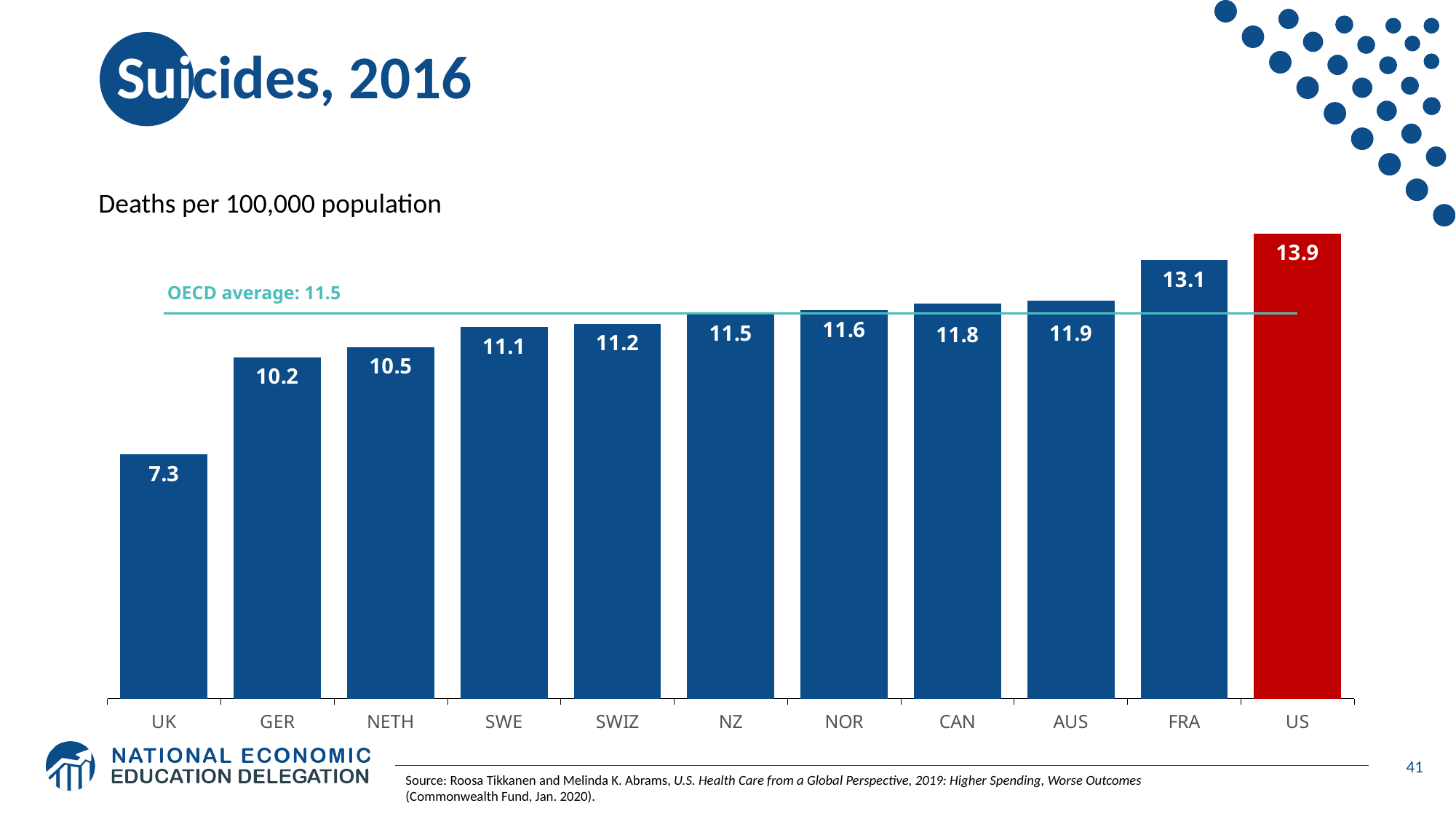
Which country has the lowest suicide rate on the chart? UK What is the difference between the FRA value and the GER value? 2.9 Which country has the highest suicide rate on the chart? US What kind of chart is shown on the slide? Bar chart What OECD average is marked by the horizontal line on the chart? 11.5 What is the value shown for FRA? 13.1 What is the difference between the US value and the UK value? 6.6 How many countries are shown on the chart? 11 Which has a higher value, CAN or NETH? CAN Do the values rise or fall moving from left to right across the chart? Rise What is the suicide rate for the UK? 7.3 What is the value shown for NOR? 11.6